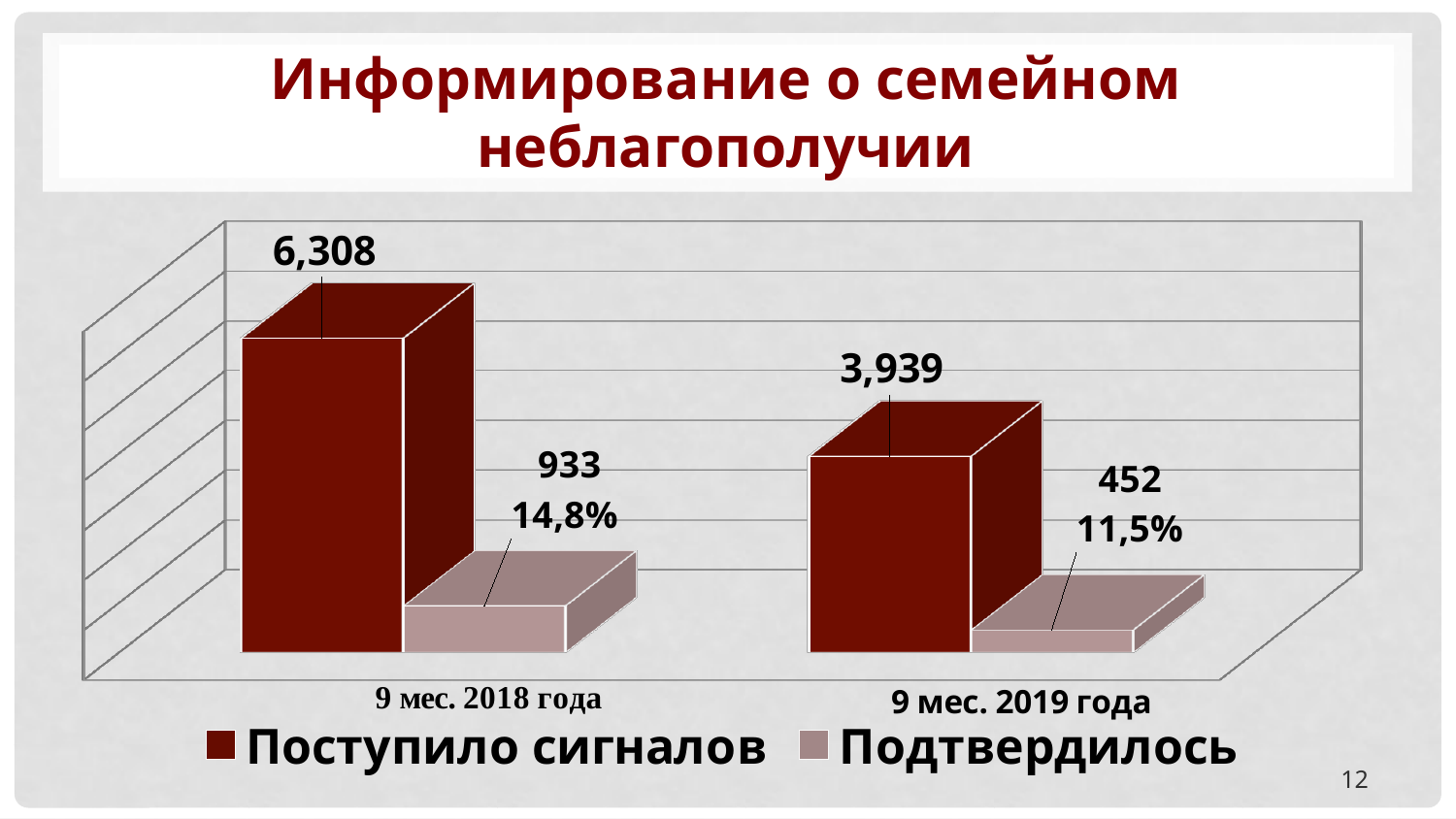
What is the value of "Поступило сигналов" for "9 мес. 2019 года"? 3,939 What kind of chart is shown on the slide? Bar chart What is the value of "Поступило сигналов" for "9 мес. 2018 года"? 6,308 Which category has the highest value for "Поступило сигналов"? 9 мес. 2018 года What is the difference between "Подтвердилось" in 9 мес. 2018 года and 9 мес. 2019 года? 481 Which is larger: "Подтвердилось" for 9 мес. 2018 года or "Подтвердилось" for 9 мес. 2019 года? 9 мес. 2018 года How many series does the legend list? 2 What percentage is shown next to the "Подтвердилось" bar for "9 мес. 2019 года"? 11,5% Which category has the lowest value for "Подтвердилось"? 9 мес. 2019 года What is the difference between "Поступило сигналов" in 9 мес. 2018 года and 9 мес. 2019 года? 2,369 What is the value of "Подтвердилось" for "9 мес. 2019 года"? 452 What percentage is shown next to the "Подтвердилось" bar for "9 мес. 2018 года"? 14,8%